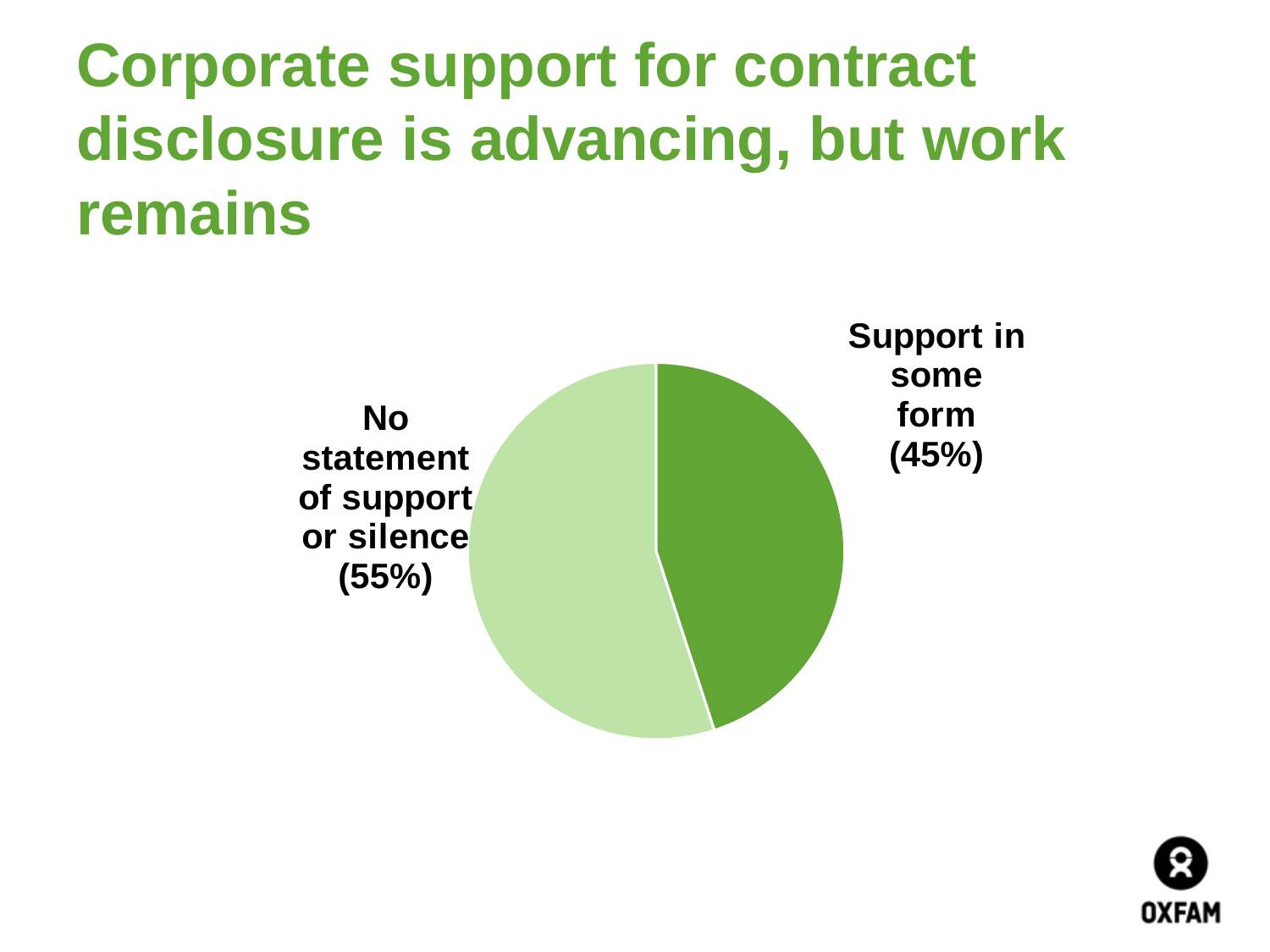
Which slice of the pie is drawn in the darker green? Support in some form What is the title of the slide containing the pie chart? Corporate support for contract disclosure is advancing, but work remains Is the share for 'Support in some form' greater or less than 50%? less What is the difference in percentage points between the 'No statement of support or silence' slice and the 'Support in some form' slice? 10 percentage points What kind of chart is shown on the slide? Pie chart What share of the pie is labelled 'No statement of support or silence'? 55% Which is larger: the 'Support in some form' slice or the 'No statement of support or silence' slice? No statement of support or silence Which slice of the pie is the smallest? Support in some form Which slice of the pie is the largest? No statement of support or silence What share of the pie is labelled 'Support in some form'? 45% How many slices does the pie chart have? 2